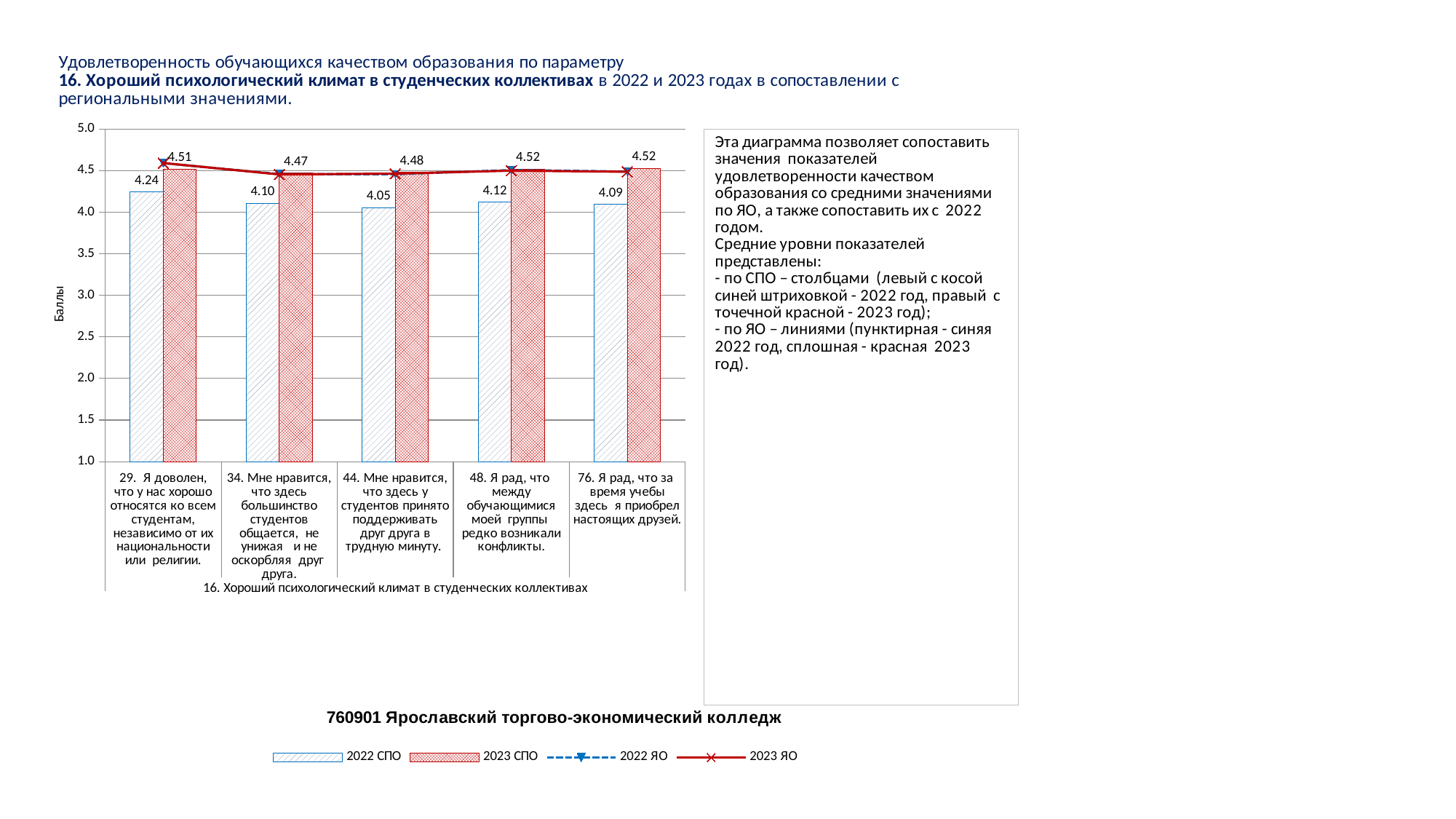
What is the difference between the 2023 СПО and 2022 СПО values for item 76 (Я рад, что за время учебы здесь я приобрел настоящих друзей)? 0.43 What is the 2023 СПО value for item 34 (Мне нравится, что здесь большинство студентов общается, не унижая и не оскорбляя друг друга)? 4.47 What is the 2022 СПО value for item 29 (Я доволен, что у нас хорошо относятся ко всем студентам...)? 4.24 Is the 2022 ЯО value for item 29 greater or less than 4.5? greater Which item has the highest 2022 СПО value? 29. Я доволен, что у нас хорошо относятся ко всем студентам, независимо от их национальности или религии. What is the label of the y axis? Баллы What type of chart is used for the СПО values? Bar chart What is the 2023 СПО value for item 44 (Мне нравится, что здесь у студентов принято поддерживать друг друга в трудную минуту)? 4.48 Which is larger for item 48: the 2022 СПО value or the 2023 СПО value? 2023 СПО Which item has the lowest 2022 СПО value? 44. Мне нравится, что здесь у студентов принято поддерживать друг друга в трудную минуту. How many items (categories) are shown on the x axis? 5 How many series does the legend list? 4